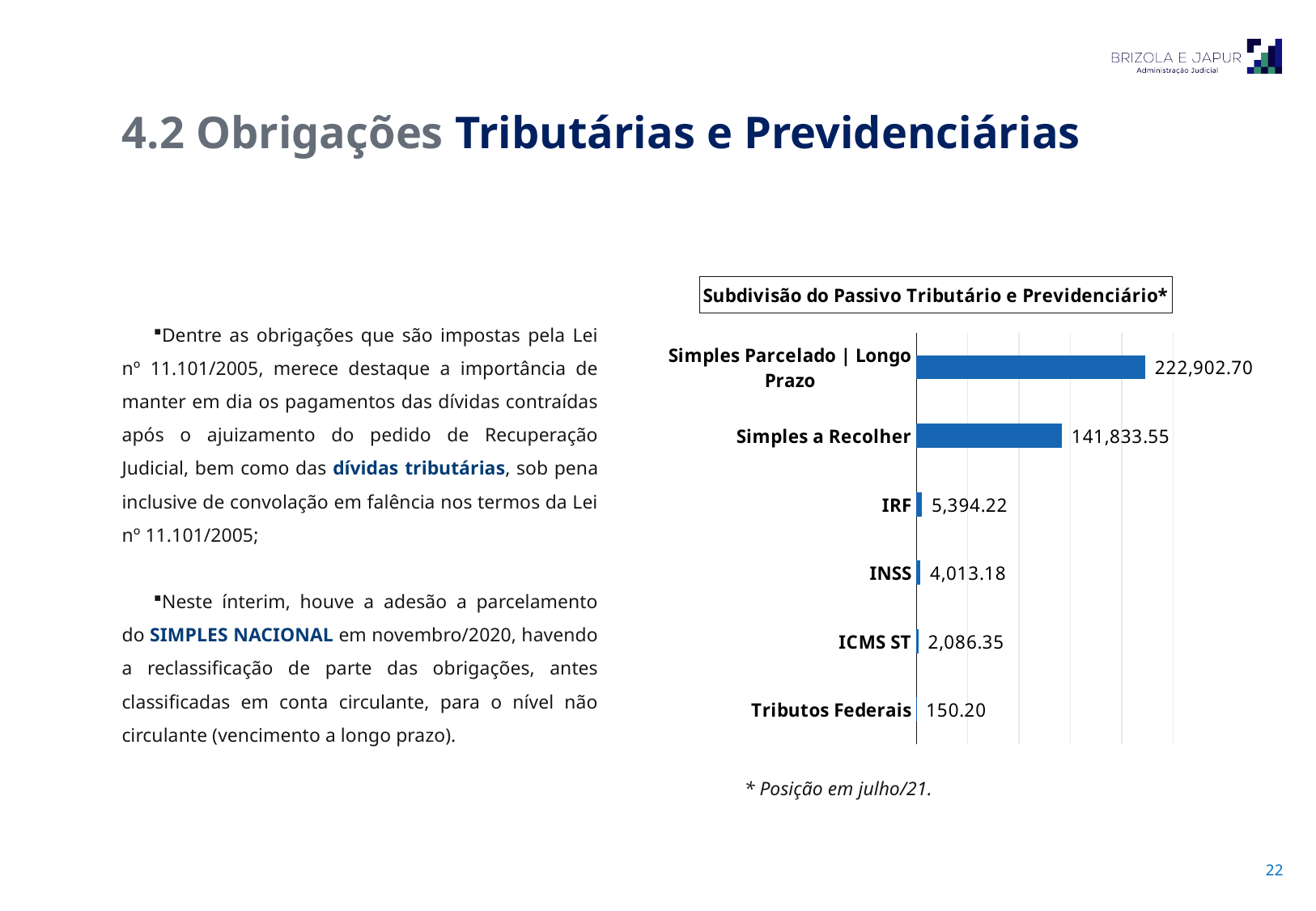
Which category has the highest value? Simples Parcelado | Longo Prazo How many categories are shown in the chart? 6 Which category has the lowest value? Tributos Federais What is the difference between Simples Parcelado | Longo Prazo and Simples a Recolher? 81,069.15 What is the value for Tributos Federais? 150.20 What is the value for INSS? 4,013.18 What is the value for ICMS ST? 2,086.35 What is the value for Simples a Recolher? 141,833.55 Which is larger, IRF or INSS? IRF What is the value for IRF? 5,394.22 What is the value for Simples Parcelado | Longo Prazo? 222,902.70 What type of chart is shown on the slide? Bar chart